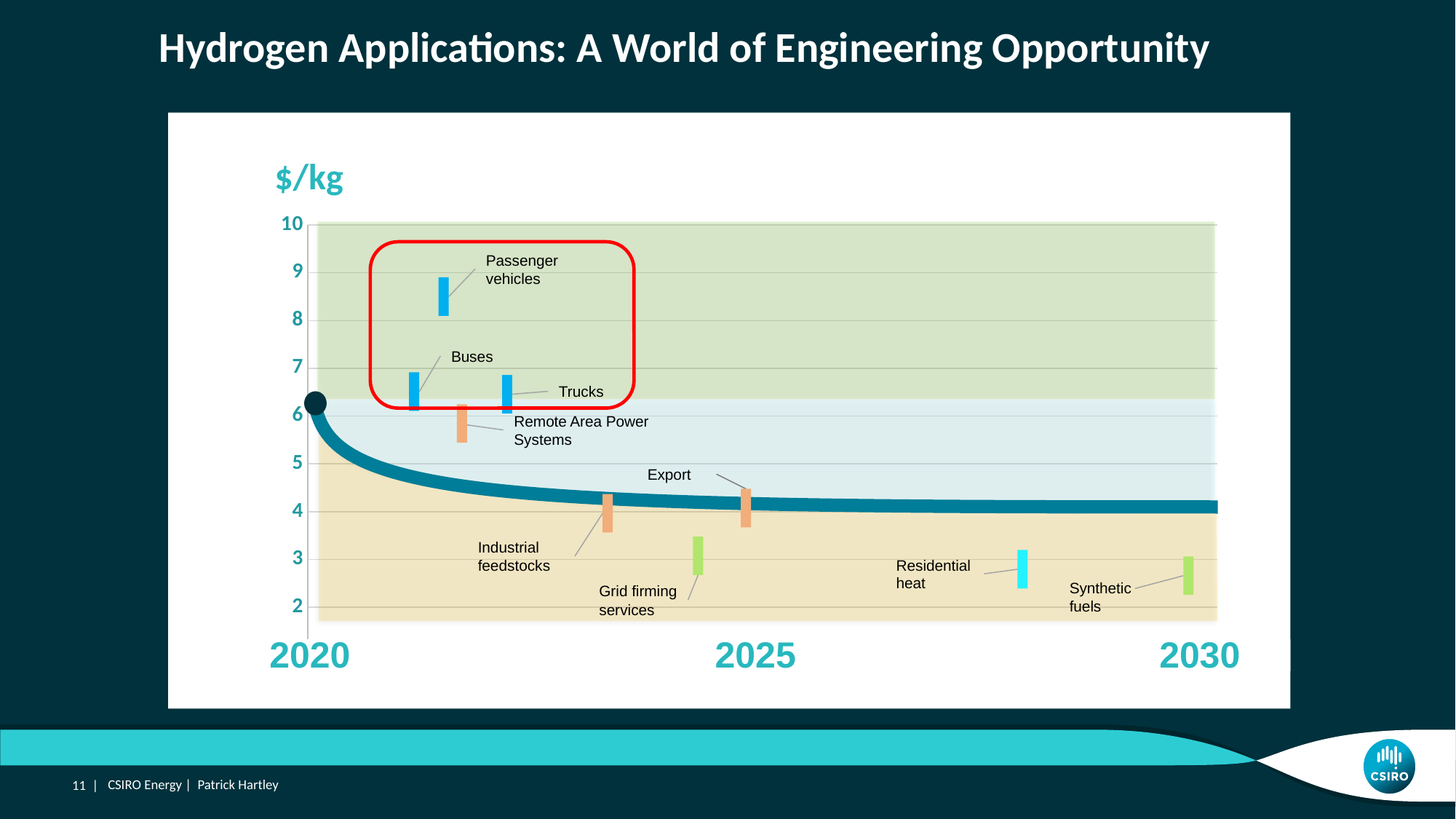
Is the $/kg value for Remote Area Power Systems greater or less than 7? less Is the $/kg value for Synthetic fuels greater or less than 4? less How many hydrogen applications are labelled on the chart? 9 What unit is shown on the y axis of the chart? $/kg Which is positioned at a higher $/kg, Passenger vehicles or Buses? Passenger vehicles Is the $/kg value for Grid firming services greater or less than 4? less Which is positioned at a higher $/kg, Export or Residential heat? Export Which application is positioned at the highest $/kg on the chart? Passenger vehicles Which years are labelled on the x axis of the chart? 2020, 2025, 2030 Does the cost curve rise or fall from 2020 to 2030? fall